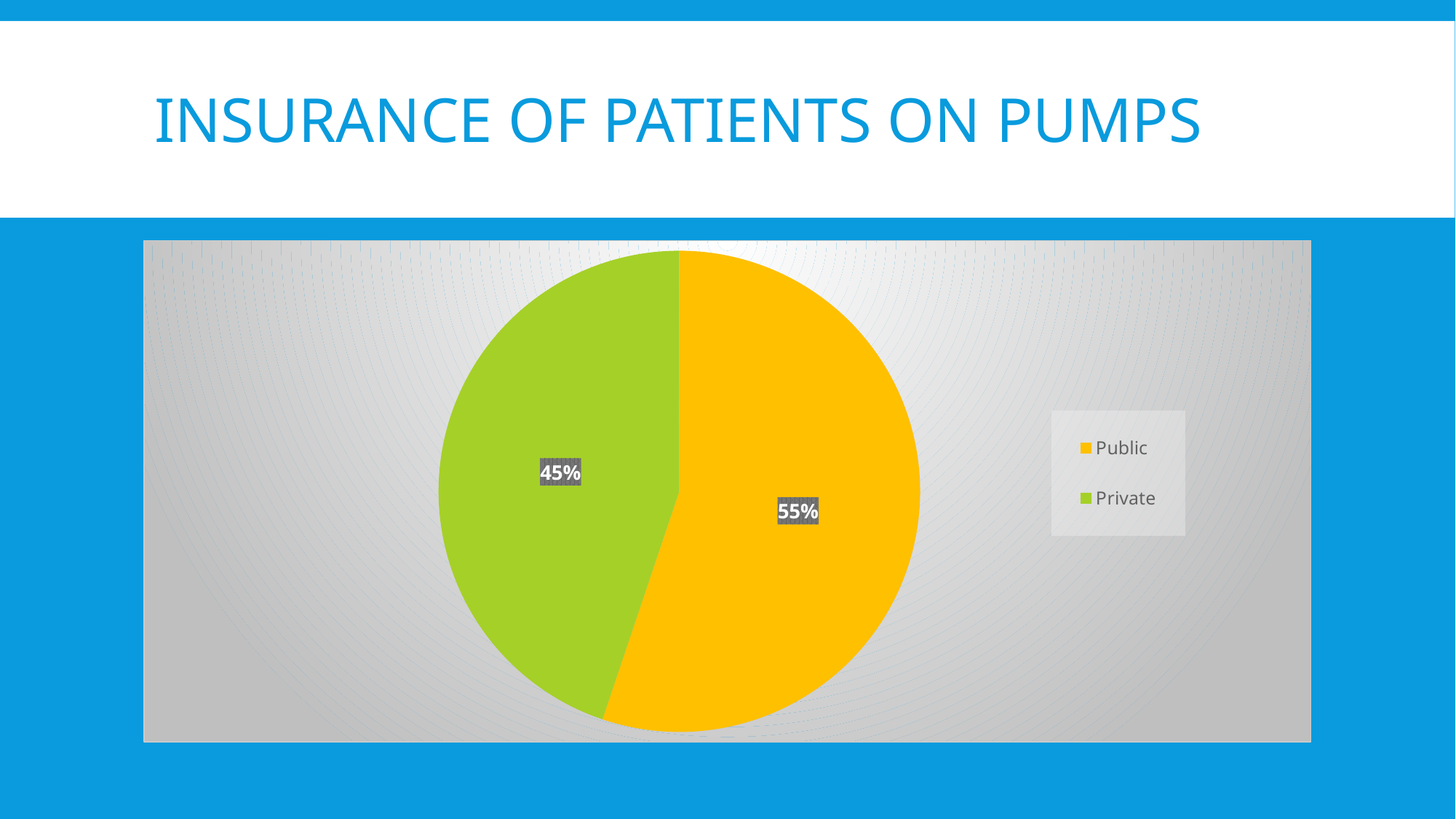
What share of patients on pumps have Public insurance? 55% What share of patients on pumps have Private insurance? 45% What colour represents the Private slice in the pie chart? green Which insurance category has the largest share of the pie? Public What is the title of the slide containing the pie chart? INSURANCE OF PATIENTS ON PUMPS How many slices does the pie chart have? 2 Which insurance category has the smallest share of the pie? Private How many entries does the legend list? 2 Which is larger, the Public share or the Private share? Public What is the difference in percentage points between the Public and Private shares? 10% What type of chart is shown on the slide? pie chart